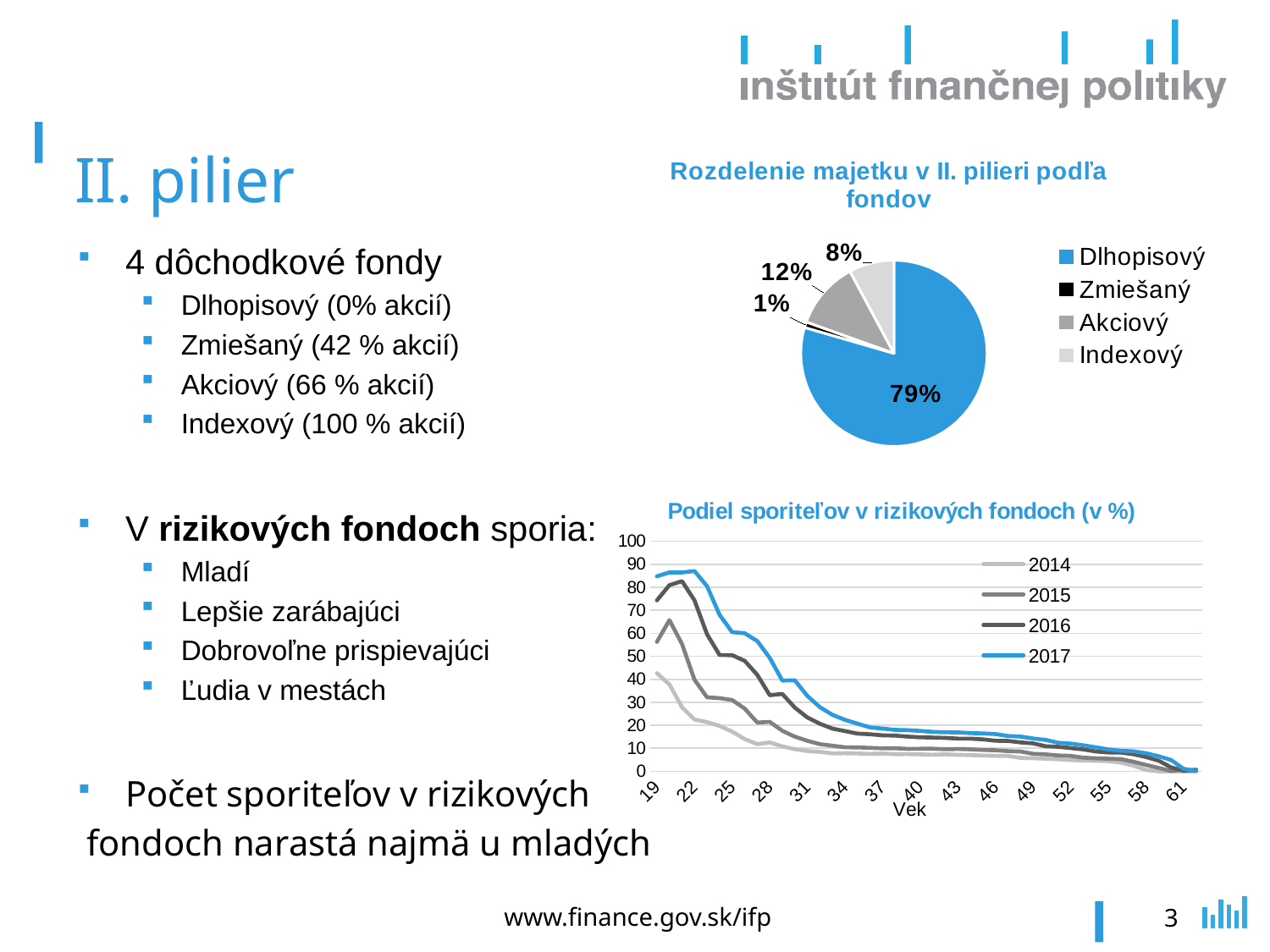
In the pie chart 'Rozdelenie majetku v II. pilieri podľa fondov', which is larger, the Akciový share or the Indexový share? Akciový In the chart 'Podiel sporiteľov v rizikových fondoch (v %)', is the value for 2017 at age 19 greater or less than 80? greater In the pie chart 'Rozdelenie majetku v II. pilieri podľa fondov', what is the difference in percentage points between the Akciový and Indexový shares? 4 percentage points What type of chart is 'Podiel sporiteľov v rizikových fondoch (v %)'? Line chart In the chart 'Podiel sporiteľov v rizikových fondoch (v %)', do the values for 2017 rise or fall as age (Vek) increases? Fall In the pie chart 'Rozdelenie majetku v II. pilieri podľa fondov', which fund has the smallest share? Zmiešaný How many slices does the pie chart 'Rozdelenie majetku v II. pilieri podľa fondov' have? 4 In the pie chart 'Rozdelenie majetku v II. pilieri podľa fondov', what share does the Dlhopisový fund have? 79% In the pie chart 'Rozdelenie majetku v II. pilieri podľa fondov', what share does the Akciový fund have? 12% In the pie chart 'Rozdelenie majetku v II. pilieri podľa fondov', which fund has the largest share? Dlhopisový How many series does the legend of the chart 'Podiel sporiteľov v rizikových fondoch (v %)' list? 4 In the pie chart 'Rozdelenie majetku v II. pilieri podľa fondov', what share does the Indexový fund have? 8%